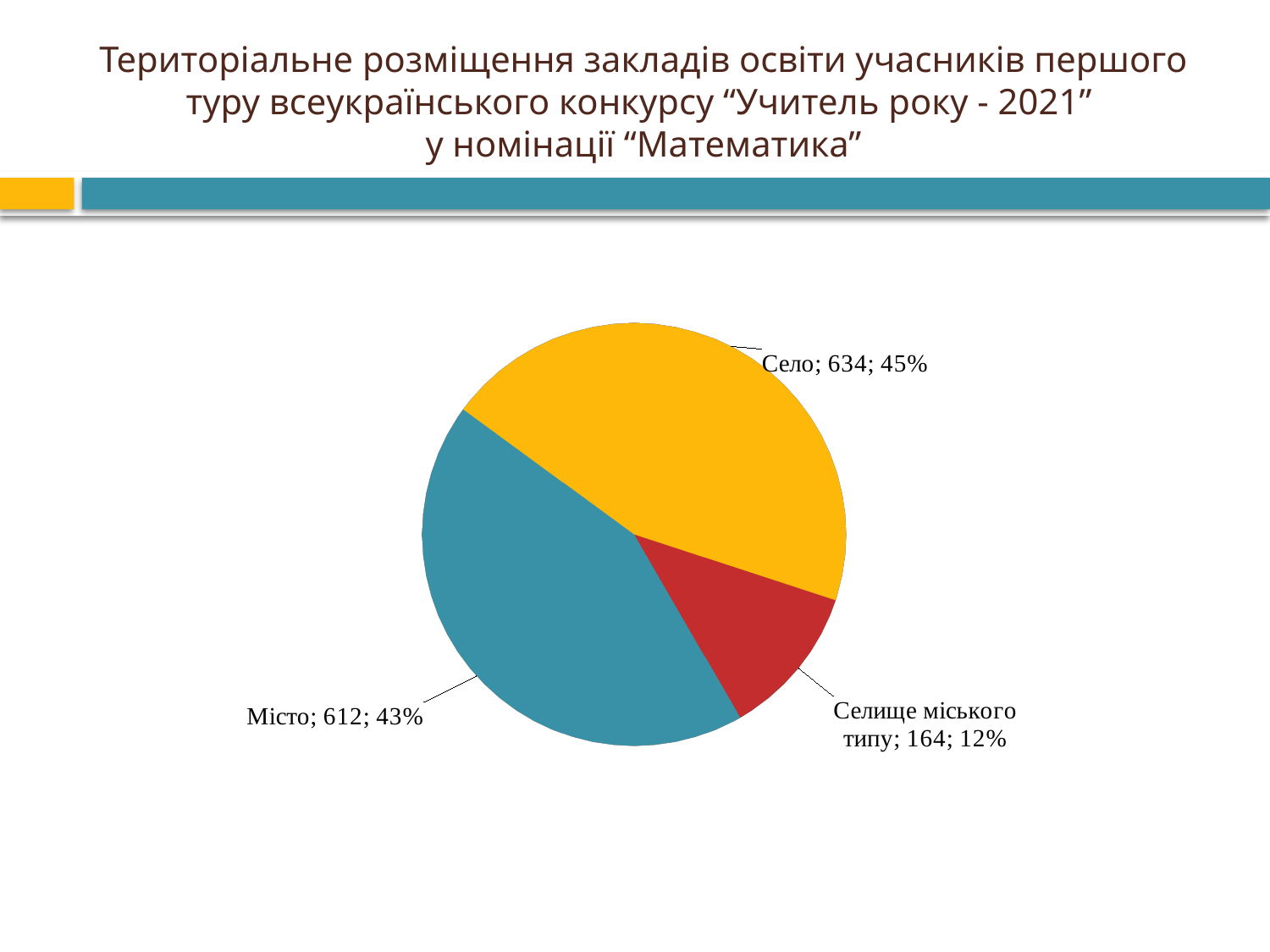
Which is larger, the value for Місто or the value for Селище міського типу? Місто What is the value for Місто? 612 What share of the pie does Село represent? 45% Which category has the smallest slice? Селище міського типу What colour is the slice for Місто? teal blue How many slices does the pie chart have? 3 Which category has the largest slice? Село What share of the pie does Селище міського типу represent? 12% What kind of chart is shown on the slide? pie chart What is the value for Село? 634 What is the difference between the values for Село and Місто? 22 What is the value for Селище міського типу? 164